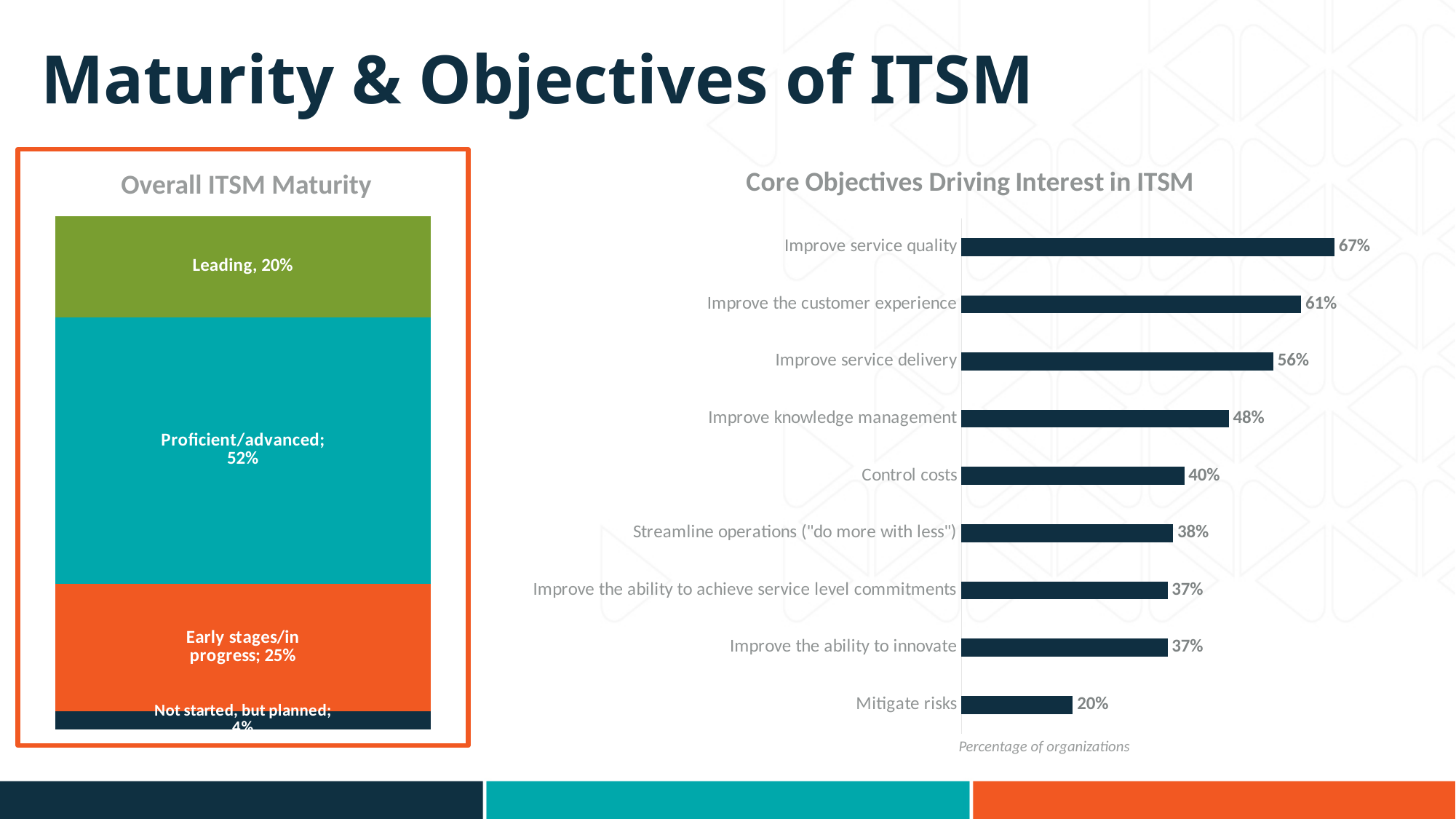
In the 'Core Objectives Driving Interest in ITSM' chart, which objective has the lowest value? Mitigate risks In the 'Core Objectives Driving Interest in ITSM' chart, which objective has the highest value? Improve service quality How many objectives are listed in the 'Core Objectives Driving Interest in ITSM' chart? 9 In the 'Overall ITSM Maturity' chart, which maturity level has the largest share? Proficient/advanced In the 'Core Objectives Driving Interest in ITSM' chart, what is the value for 'Improve service quality'? 67% In the 'Core Objectives Driving Interest in ITSM' chart, what is the value for 'Control costs'? 40% In the 'Overall ITSM Maturity' chart, what is the difference between 'Early stages/in progress' and 'Leading'? 5% In the 'Core Objectives Driving Interest in ITSM' chart, what is the difference between 'Improve the customer experience' and 'Improve knowledge management'? 13% In the 'Overall ITSM Maturity' chart, what is the value for 'Not started, but planned'? 4% In the 'Overall ITSM Maturity' chart, what is the value for 'Proficient/advanced'? 52% What kind of chart is 'Core Objectives Driving Interest in ITSM'? Bar chart In the 'Core Objectives Driving Interest in ITSM' chart, which is larger: 'Improve service delivery' or 'Streamline operations ("do more with less")'? Improve service delivery